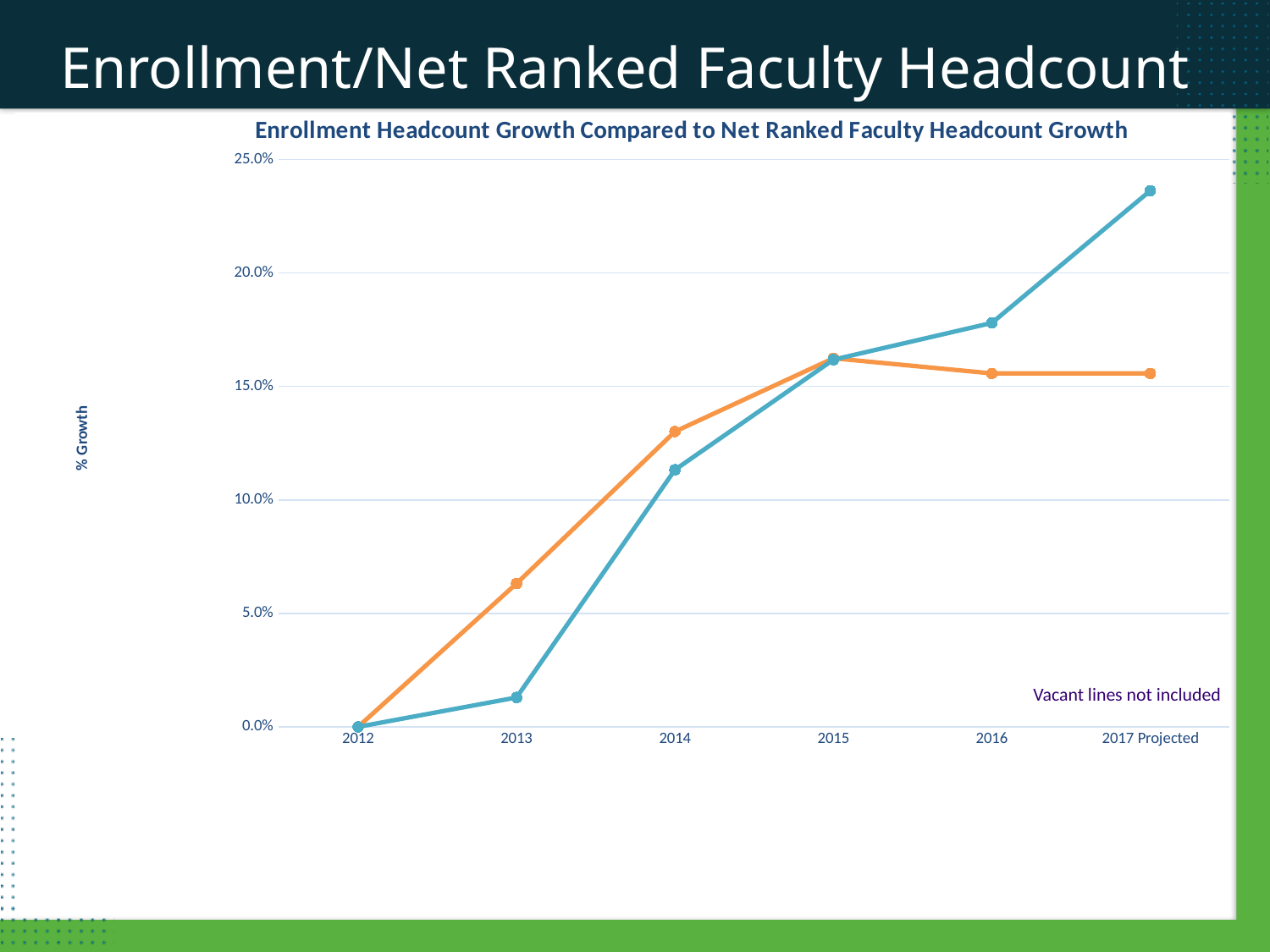
Is the value of the blue line for 2017 Projected greater or less than 20.0%? greater What kind of chart is shown on the slide? line chart In which year does the blue line reach its highest value? 2017 Projected In 2013, which line has the higher value, the blue line or the orange line? the orange line What is the title of the chart? Enrollment Headcount Growth Compared to Net Ranked Faculty Headcount Growth What is the value of the blue line in 2012? 0.0% Is the value of the orange line for 2017 Projected greater or less than 20.0%? less How many years (points) are plotted along the x axis? 6 What is the label on the vertical axis of the chart? % Growth Is the value of the orange line for 2013 greater or less than 5.0%? greater